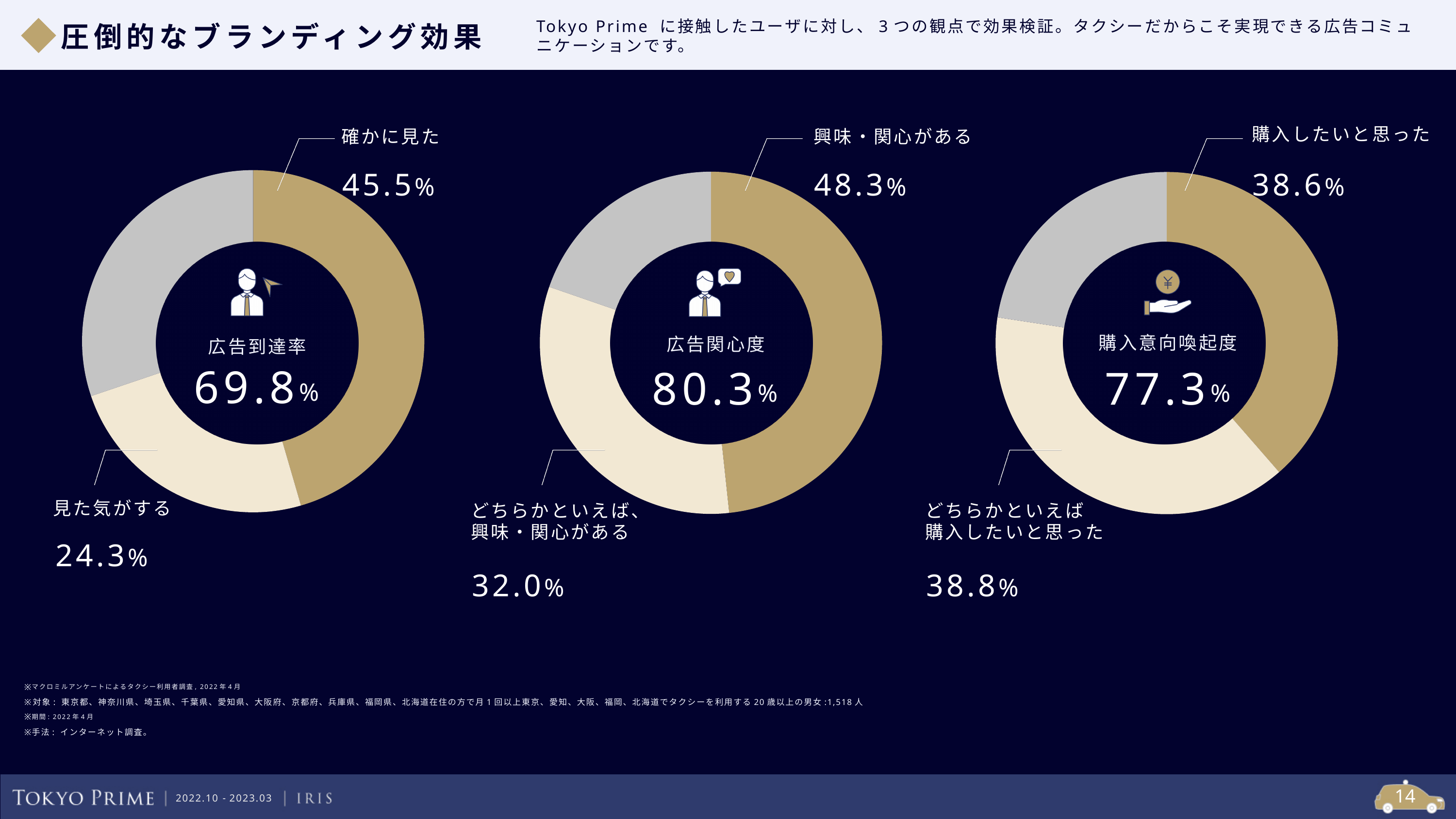
In the 購入意向喚起度 chart, what is the value for 購入したいと思った? 38.6% In the 広告関心度 chart, what is the value for どちらかといえば、興味・関心がある? 32.0% What is the overall value shown in the centre of the 広告到達率 chart? 69.8% In the 広告到達率 chart, what is the value for 確かに見た? 45.5% What kind of chart is used for 広告到達率? Pie (donut) chart What is the overall value shown in the centre of the 購入意向喚起度 chart? 77.3% In the 広告関心度 chart, what is the combined total of 興味・関心がある and どちらかといえば、興味・関心がある? 80.3% How many donut charts are shown on the slide? 3 In the 広告関心度 chart, which is larger: 興味・関心がある or どちらかといえば、興味・関心がある? 興味・関心がある In the 広告関心度 chart, what is the value for 興味・関心がある? 48.3% In the 広告到達率 chart, what is the value for 見た気がする? 24.3% In the 広告到達率 chart, what is the difference between 確かに見た and 見た気がする? 21.2%